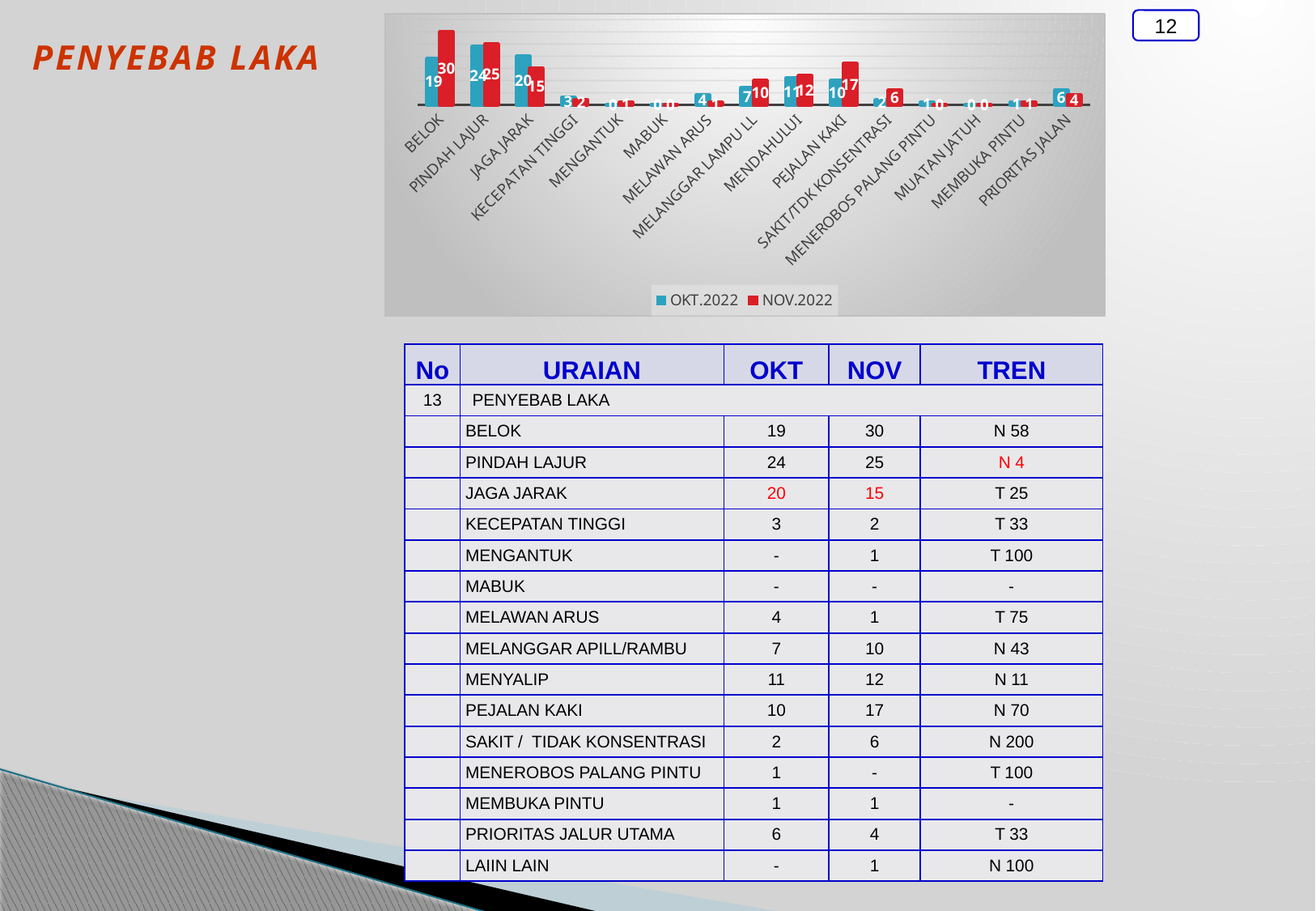
What is the NOV.2022 value for BELOK in the chart? 30 What is the difference between the NOV.2022 and OKT.2022 values for BELOK? 11 What is the difference between the OKT.2022 and NOV.2022 values for PEJALAN KAKI? 7 What is the OKT.2022 value for PINDAH LAJUR in the chart? 24 How many series does the chart legend list? 2 What are the two series named in the chart legend? OKT.2022 and NOV.2022 What type of chart is shown on the slide? bar chart What is the NOV.2022 value for PEJALAN KAKI in the chart? 17 For JAGA JARAK, which is larger: the OKT.2022 value or the NOV.2022 value? OKT.2022 Which colour represents the NOV.2022 series in the chart? red Which category has the highest OKT.2022 value in the chart? PINDAH LAJUR Which category has the highest NOV.2022 value in the chart? BELOK